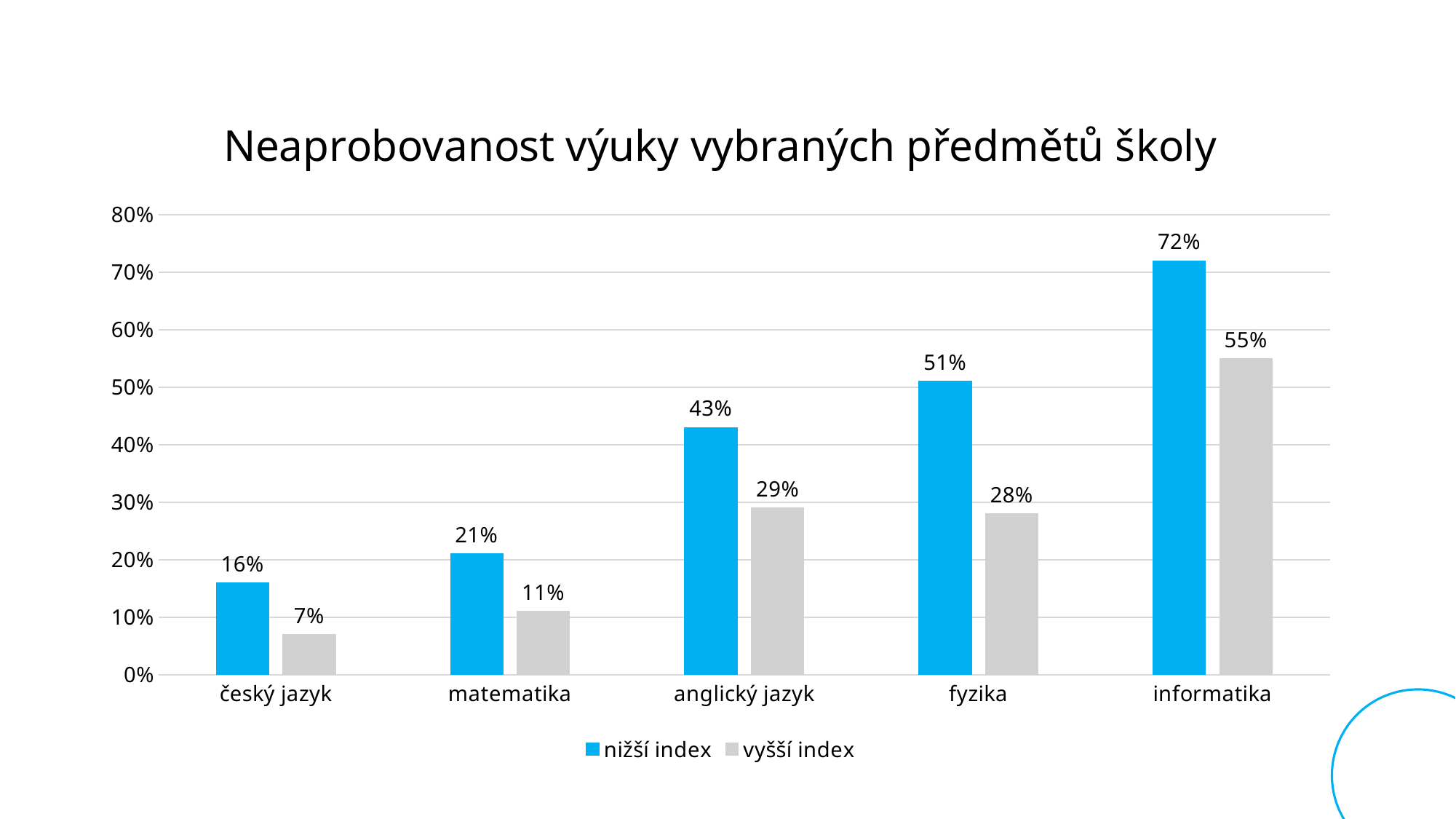
Is the 'nižší index' value for matematika greater or less than 30%? less Which is larger: the 'vyšší index' value for anglický jazyk or for fyzika? anglický jazyk What is the difference between the 'nižší index' and 'vyšší index' values for fyzika? 23% What is the title of the chart? Neaprobovanost výuky vybraných předmětů školy What kind of chart is shown on the slide? bar chart What is the value for 'vyšší index' for anglický jazyk? 29% What is the value for 'vyšší index' for český jazyk? 7% What is the value for 'nižší index' for informatika? 72% Which category has the lowest 'vyšší index' value? český jazyk Which category has the highest 'nižší index' value? informatika How many series does the legend list? 2 How many categories are shown on the x axis? 5